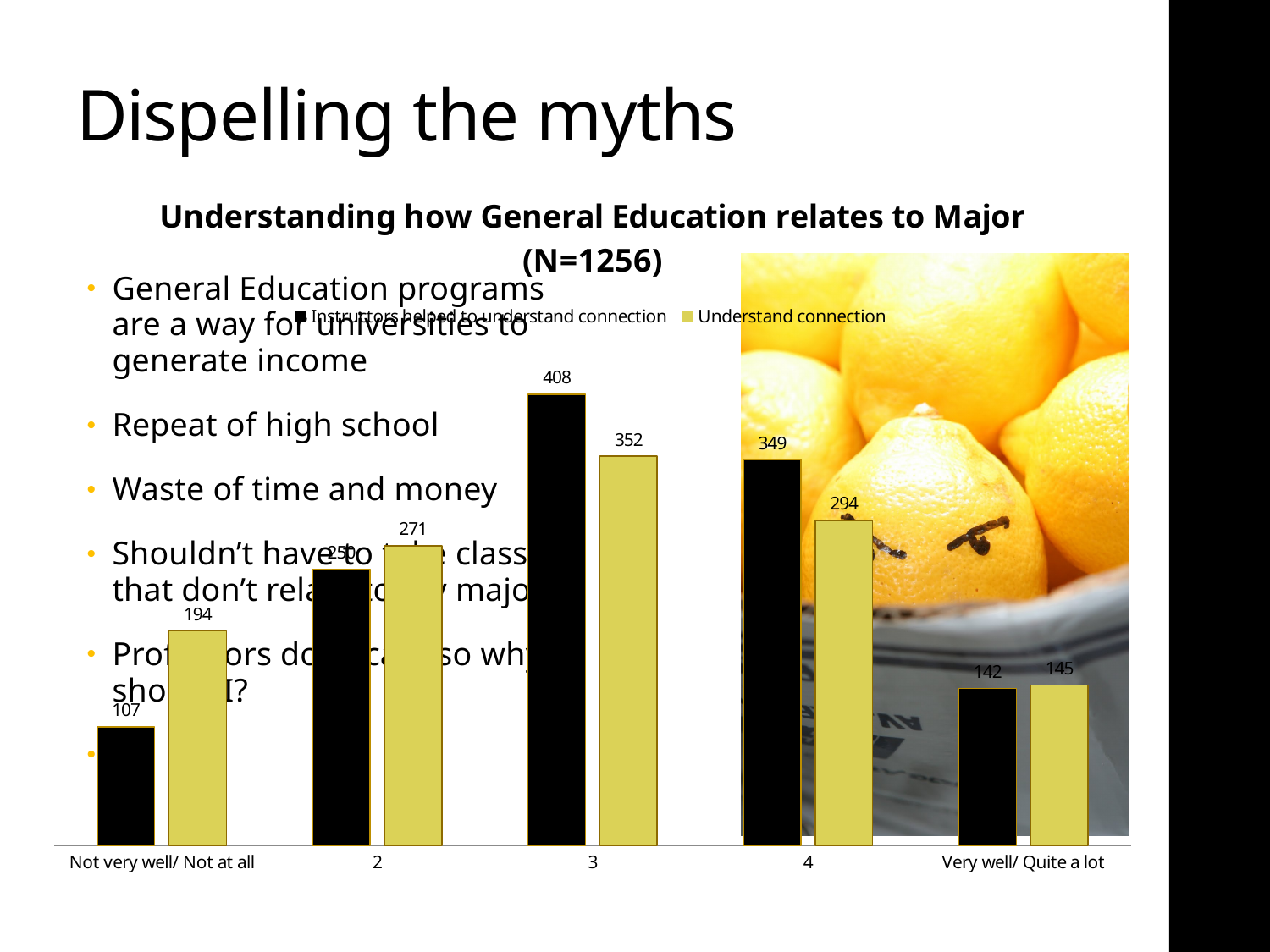
How many categories are shown on the x axis of the chart? 5 What is the title of the chart? Understanding how General Education relates to Major (N=1256) What type of chart is shown on the slide? bar chart What is the difference between the 'Instructors helped to understand connection' and 'Understand connection' values in category 3? 56 What is the value for 'Understand connection' in category 4? 294 Which category has the lowest value for 'Understand connection'? Very well/ Quite a lot What is the value for 'Instructors helped to understand connection' in category 3? 408 In category 4, which series has the larger value: 'Instructors helped to understand connection' or 'Understand connection'? Instructors helped to understand connection How many series does the chart legend list? 2 What is the value for 'Instructors helped to understand connection' in the 'Very well/ Quite a lot' category? 142 What is the value for 'Understand connection' in the 'Not very well/ Not at all' category? 194 Which category has the highest value for 'Instructors helped to understand connection'? 3